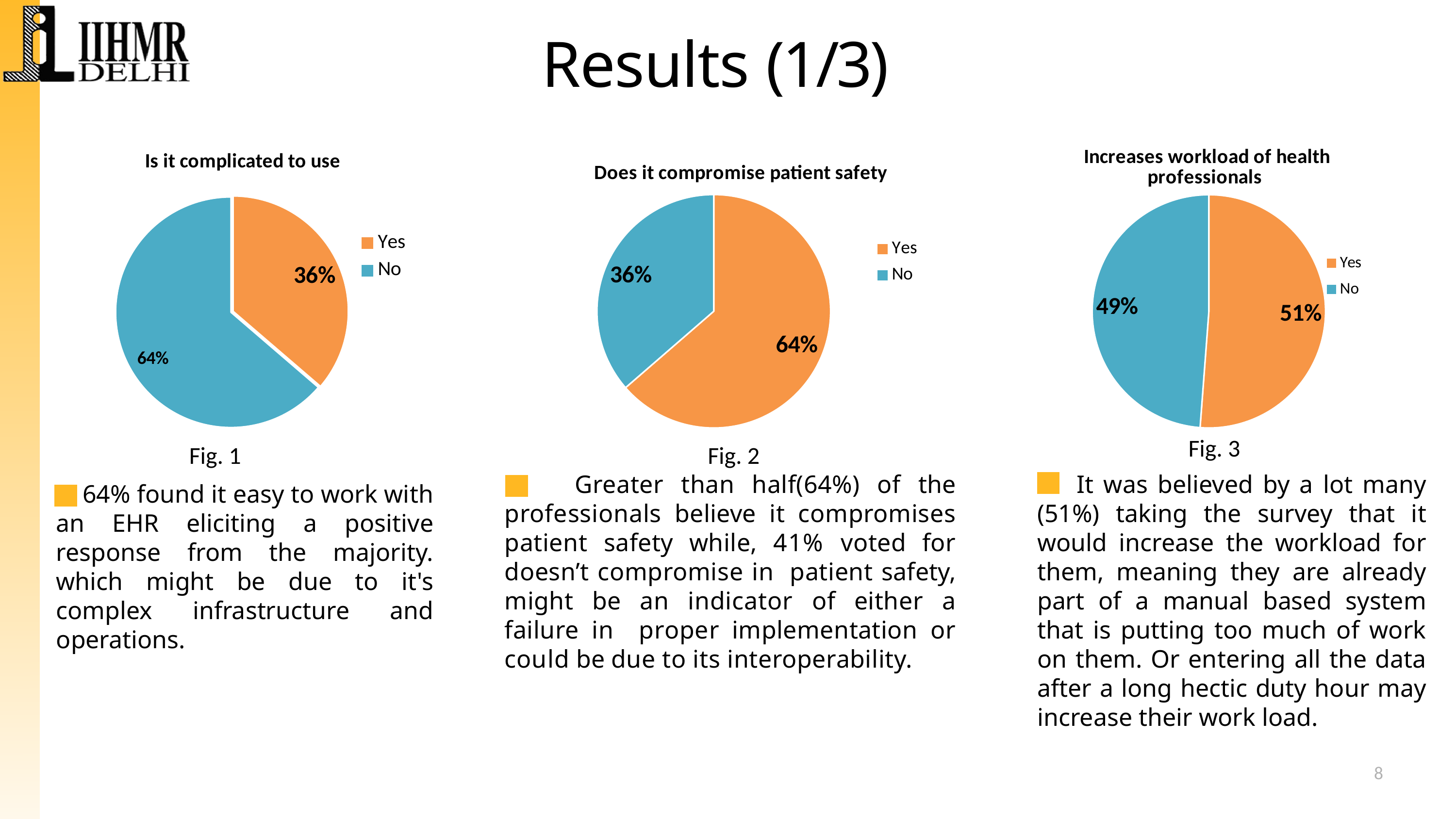
In the 'Does it compromise patient safety' pie chart, which slice is the largest? Yes In the 'Is it complicated to use' pie chart, which slice is larger, 'Yes' or 'No'? No In the 'Does it compromise patient safety' pie chart, what share of responses is 'Yes'? 64% What type of chart is used for Fig. 2, 'Does it compromise patient safety'? Pie chart In the 'Increases workload of health professionals' pie chart, what share of responses is 'No'? 49% In the 'Does it compromise patient safety' pie chart, what share of responses is 'No'? 36% In the 'Is it complicated to use' pie chart, what share of responses is 'Yes'? 36% In the 'Increases workload of health professionals' pie chart, what share of responses is 'Yes'? 51% In the 'Increases workload of health professionals' pie chart, what is the difference between the 'Yes' and 'No' shares? 2% How many entries does the legend of the 'Increases workload of health professionals' chart list? 2 In the 'Is it complicated to use' pie chart, what share of responses is 'No'? 64% In the 'Is it complicated to use' pie chart, what is the difference between the 'No' and 'Yes' shares? 28%